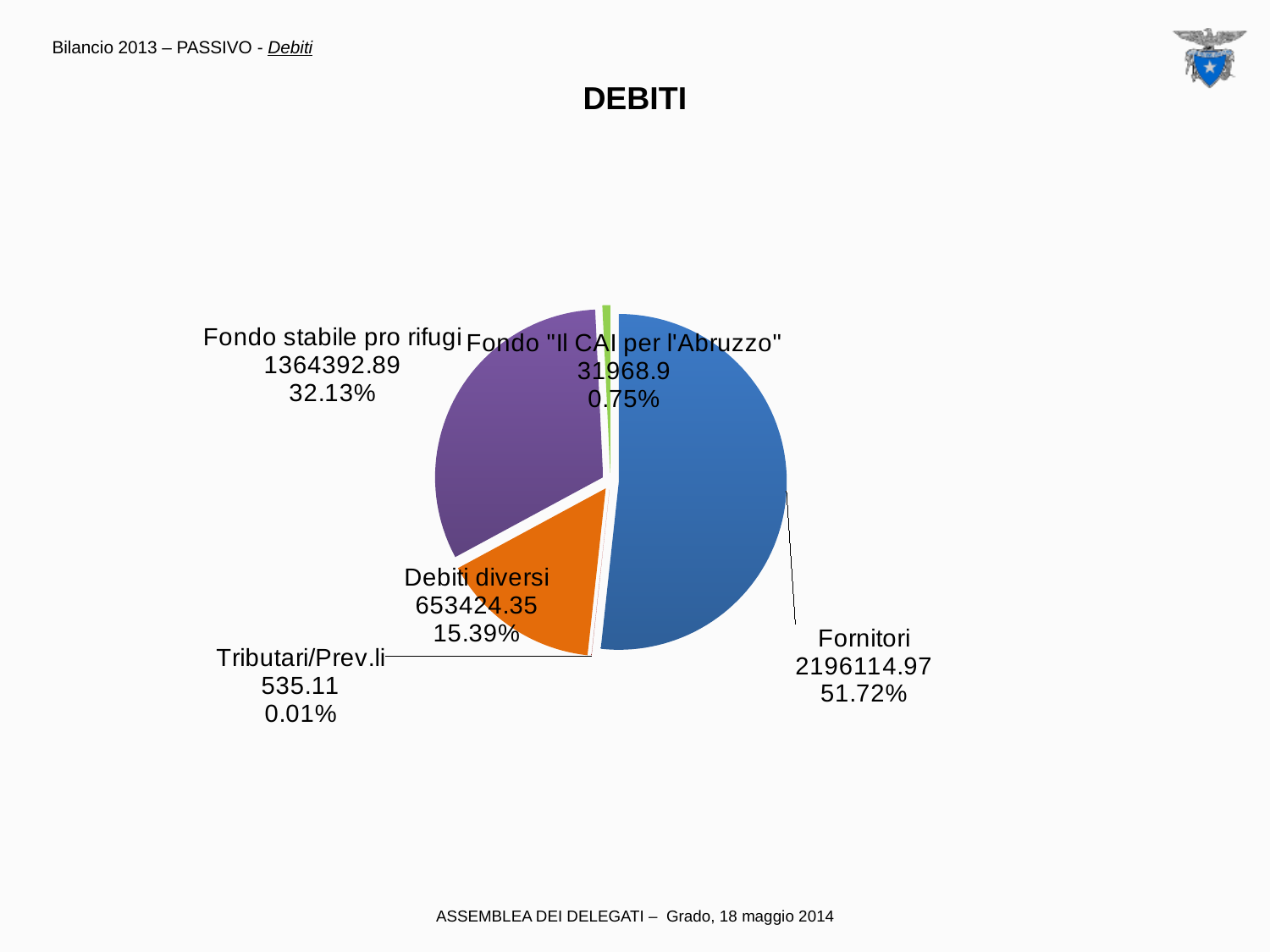
What is the difference in percentage share between Fornitori and Fondo stabile pro rifugi? 19.59% Which category has the largest slice? Fornitori What share of the pie does Fornitori represent? 51.72% What kind of chart is shown on the slide? pie chart What is the value for Fornitori? 2196114.97 What is the value for Fondo stabile pro rifugi? 1364392.89 How many slices does the pie chart have? 5 What is the title of the chart? DEBITI Which is larger, Debiti diversi or Fondo stabile pro rifugi? Fondo stabile pro rifugi What is the value for Fondo "Il CAI per l'Abruzzo"? 31968.9 Which category has the smallest slice? Tributari/Prev.li What share of the pie does Debiti diversi represent? 15.39%